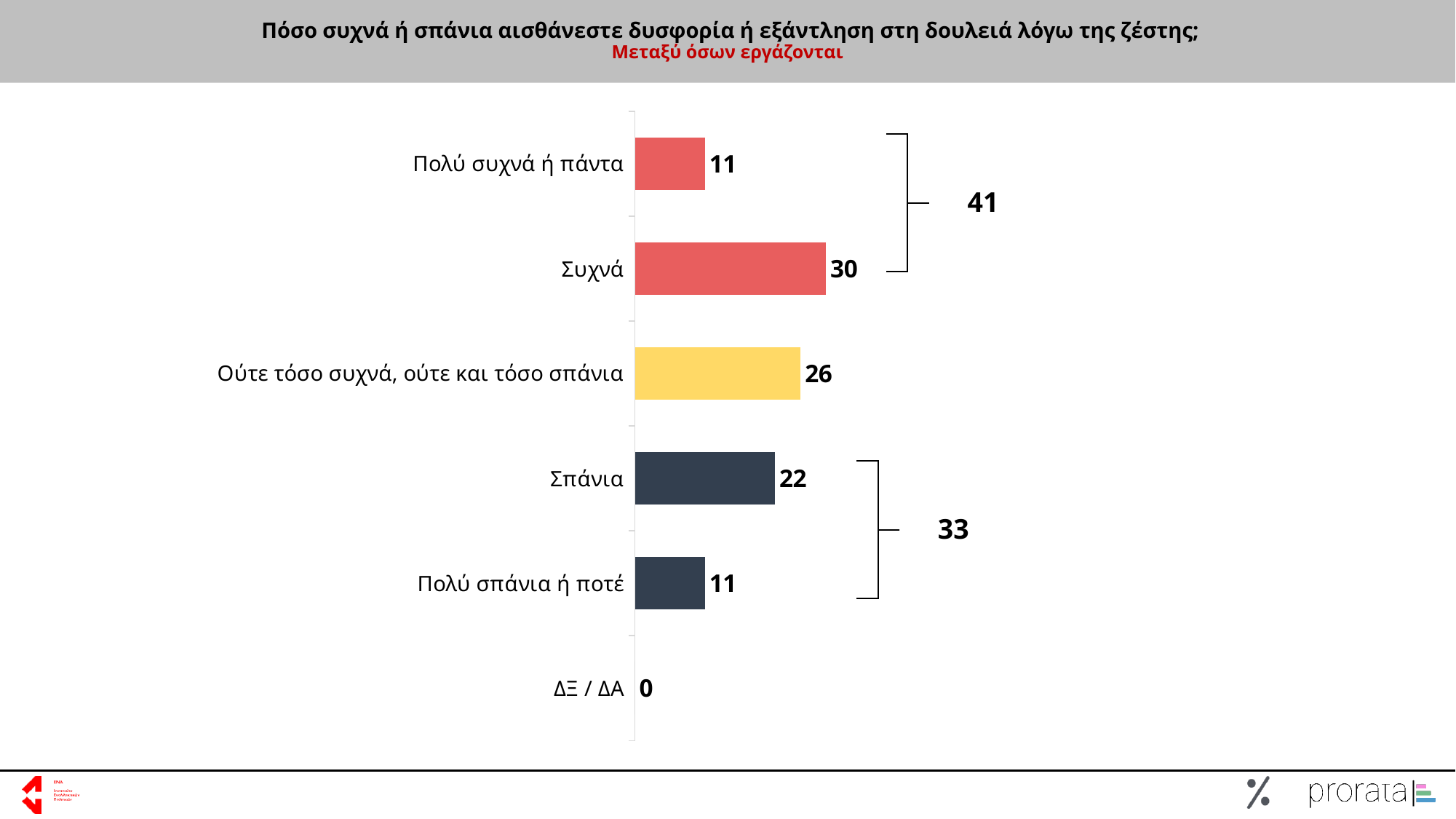
Which is larger, the value for Ούτε τόσο συχνά, ούτε και τόσο σπάνια or the value for Σπάνια? Ούτε τόσο συχνά, ούτε και τόσο σπάνια What colour are the bars for Σπάνια and Πολύ σπάνια ή ποτέ? dark blue-grey What kind of chart is shown on the slide? bar chart Which category has the highest value? Συχνά What is the value for Σπάνια? 22 What is the combined value shown by the bracket for Πολύ συχνά ή πάντα and Συχνά? 41 What is the value for Ούτε τόσο συχνά, ούτε και τόσο σπάνια? 26 What is the value for ΔΞ / ΔΑ? 0 What is the difference between the values for Συχνά and Σπάνια? 8 How many categories are shown in the chart? 6 Which category has the lowest value? ΔΞ / ΔΑ What is the value for Συχνά? 30